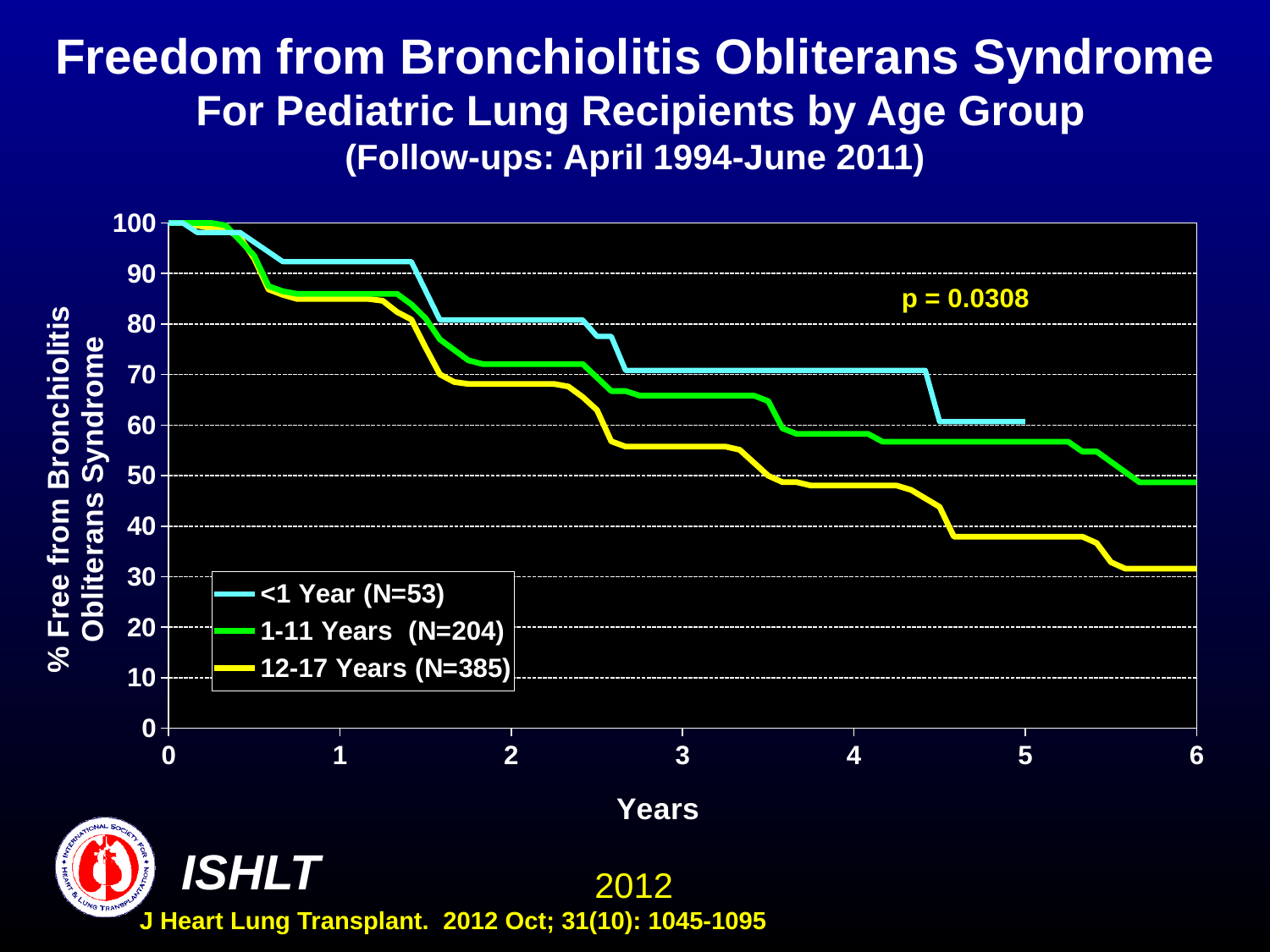
Which age group has the lowest freedom from bronchiolitis obliterans syndrome at year 4? 12-17 Years (N=385) Is the value for the 12-17 Years group at year 1 greater or less than 80? greater What p-value is printed on the chart? p = 0.0308 At year 2, which is larger: the value for the 1-11 Years group or the 12-17 Years group? 1-11 Years Do the values for the 12-17 Years group rise or fall as the years increase? fall Is the value for the 12-17 Years group at year 6 greater or less than 40? less Is the value for the <1 Year group at year 5 greater or less than 50? greater What is the sample size (N) shown in the legend for the 12-17 Years group? 385 Which age group has the highest freedom from bronchiolitis obliterans syndrome at year 3? <1 Year (N=53) How many series does the legend list? 3 What kind of chart is shown on the slide? line chart